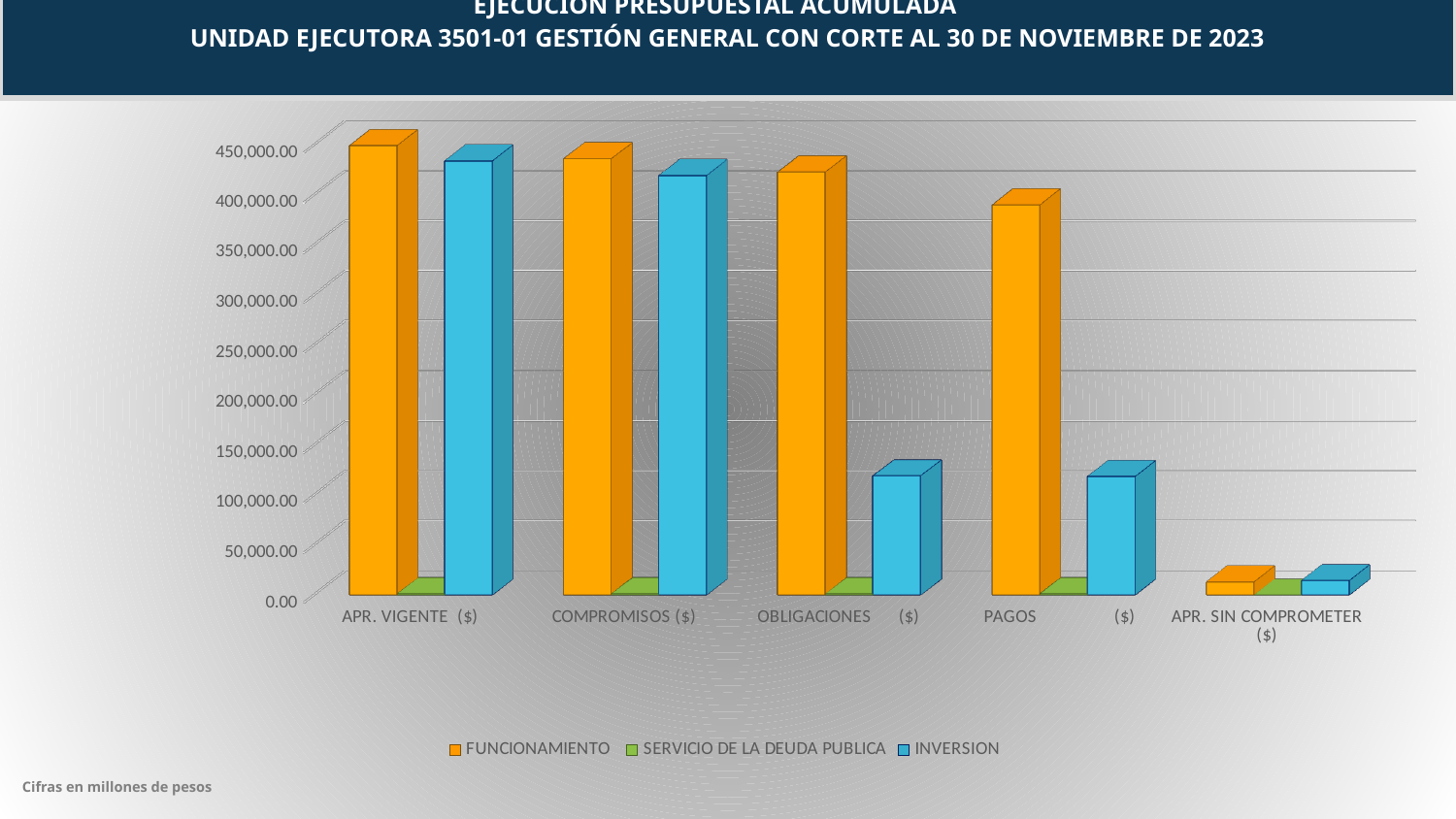
Is the FUNCIONAMIENTO value for APR. SIN COMPROMETER greater or less than 50,000.00? less For which category is the FUNCIONAMIENTO value lowest? APR. SIN COMPROMETER According to the note on the slide, in what units are the figures expressed? millones de pesos Is the INVERSION value for OBLIGACIONES greater or less than 150,000.00? less What kind of chart is shown on the slide? bar chart Is the FUNCIONAMIENTO value for PAGOS greater or less than 350,000.00? greater How many series does the chart legend list? 3 How many categories are shown along the x axis of the chart? 5 Do the FUNCIONAMIENTO values rise or fall moving from APR. VIGENTE to APR. SIN COMPROMETER along the x axis? fall For OBLIGACIONES, which series has the larger value: FUNCIONAMIENTO or INVERSION? FUNCIONAMIENTO Which series are listed in the chart legend? FUNCIONAMIENTO, SERVICIO DE LA DEUDA PUBLICA, INVERSION